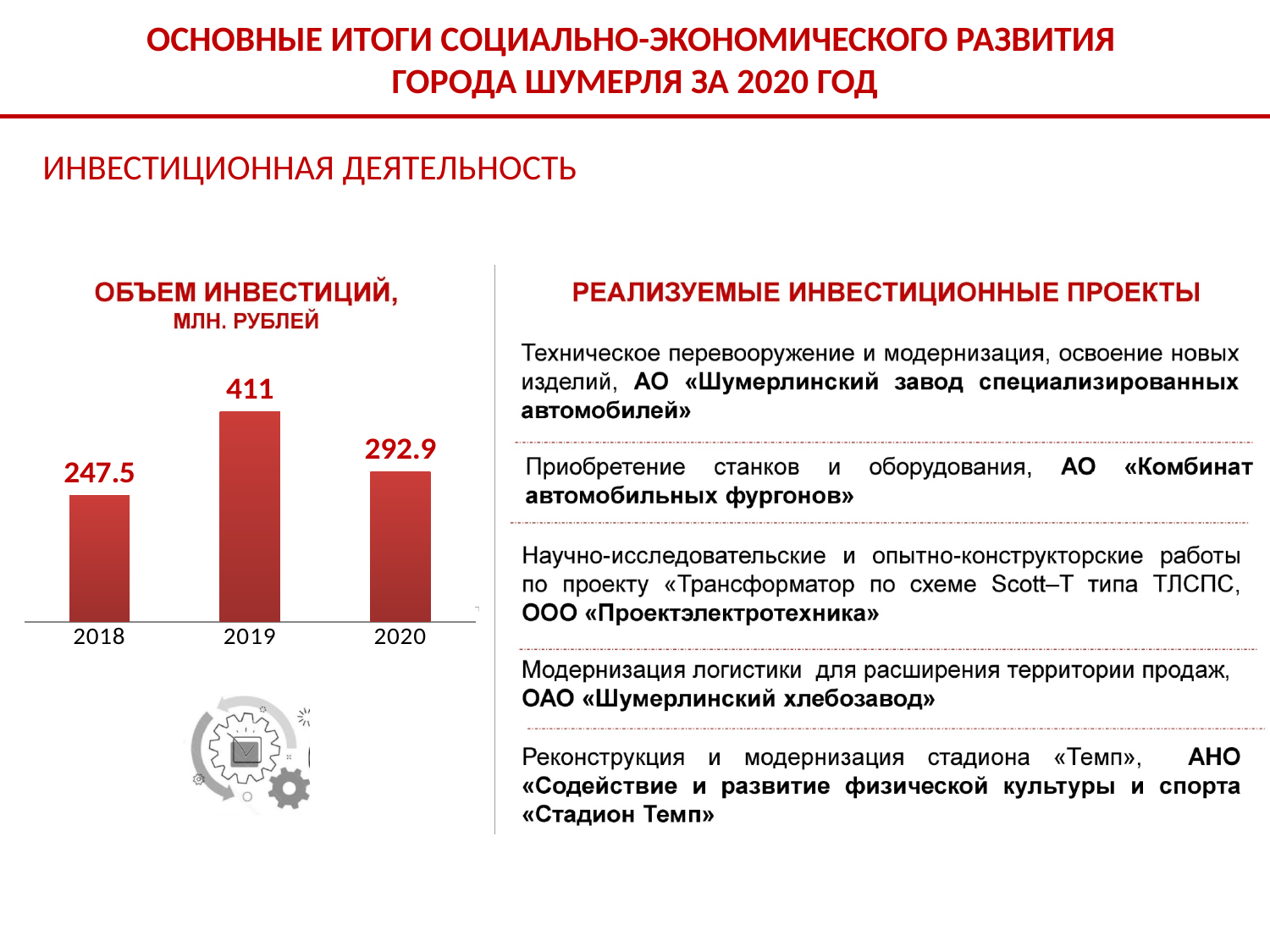
Did the volume of investments rise or fall from 2019 to 2020? Fall How many years are shown in the chart? 3 Which year had a larger volume of investments, 2018 or 2020? 2020 Which year had the lowest volume of investments? 2018 What was the volume of investments in 2018? 247.5 What was the volume of investments in 2019? 411 What is the difference between the volume of investments in 2019 and 2020? 118.1 What type of chart is used to show the volume of investments? Bar chart In what units is the volume of investments shown in the chart? млн. рублей Which year had the highest volume of investments? 2019 What was the volume of investments in 2020? 292.9 By how much did the volume of investments in 2019 exceed that of 2018? 163.5